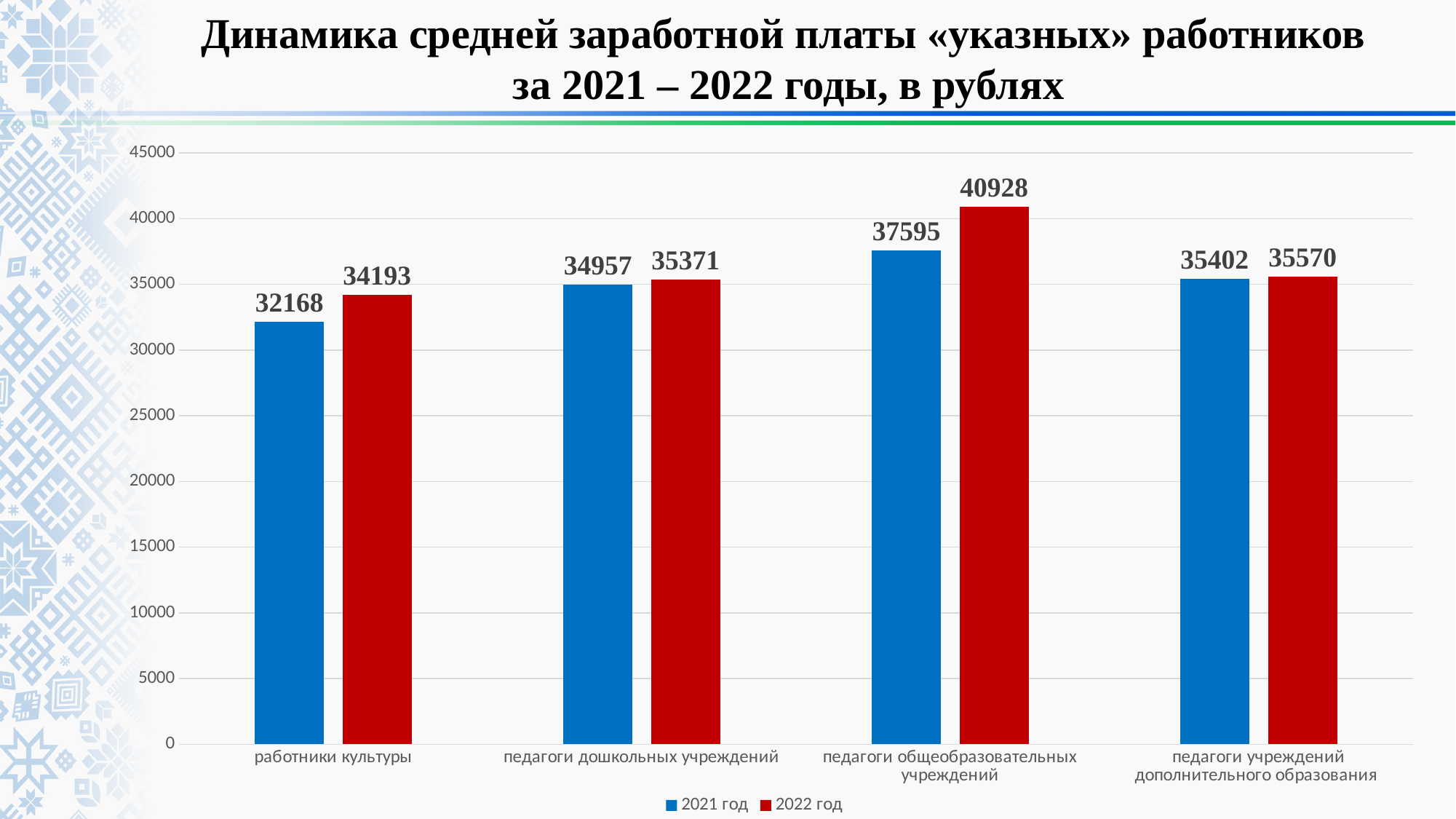
What is the 2022 год value for педагоги учреждений дополнительного образования? 35570 How many series does the legend list? 2 What is the difference between the 2022 год and 2021 год values for работники культуры? 2025 Which category has the lowest 2021 год value? работники культуры How many categories are shown on the x axis? 4 What is the 2021 год value for работники культуры? 32168 Is the 2021 год value for педагоги общеобразовательных учреждений greater or less than 40000? less Which is larger: the 2021 год value for педагоги дошкольных учреждений or the 2021 год value for педагоги учреждений дополнительного образования? педагоги учреждений дополнительного образования What is the 2022 год value for педагоги общеобразовательных учреждений? 40928 Which category has the highest 2022 год value? педагоги общеобразовательных учреждений What kind of chart is shown on the slide? bar chart What is the difference between the 2022 год and 2021 год values for педагоги общеобразовательных учреждений? 3333